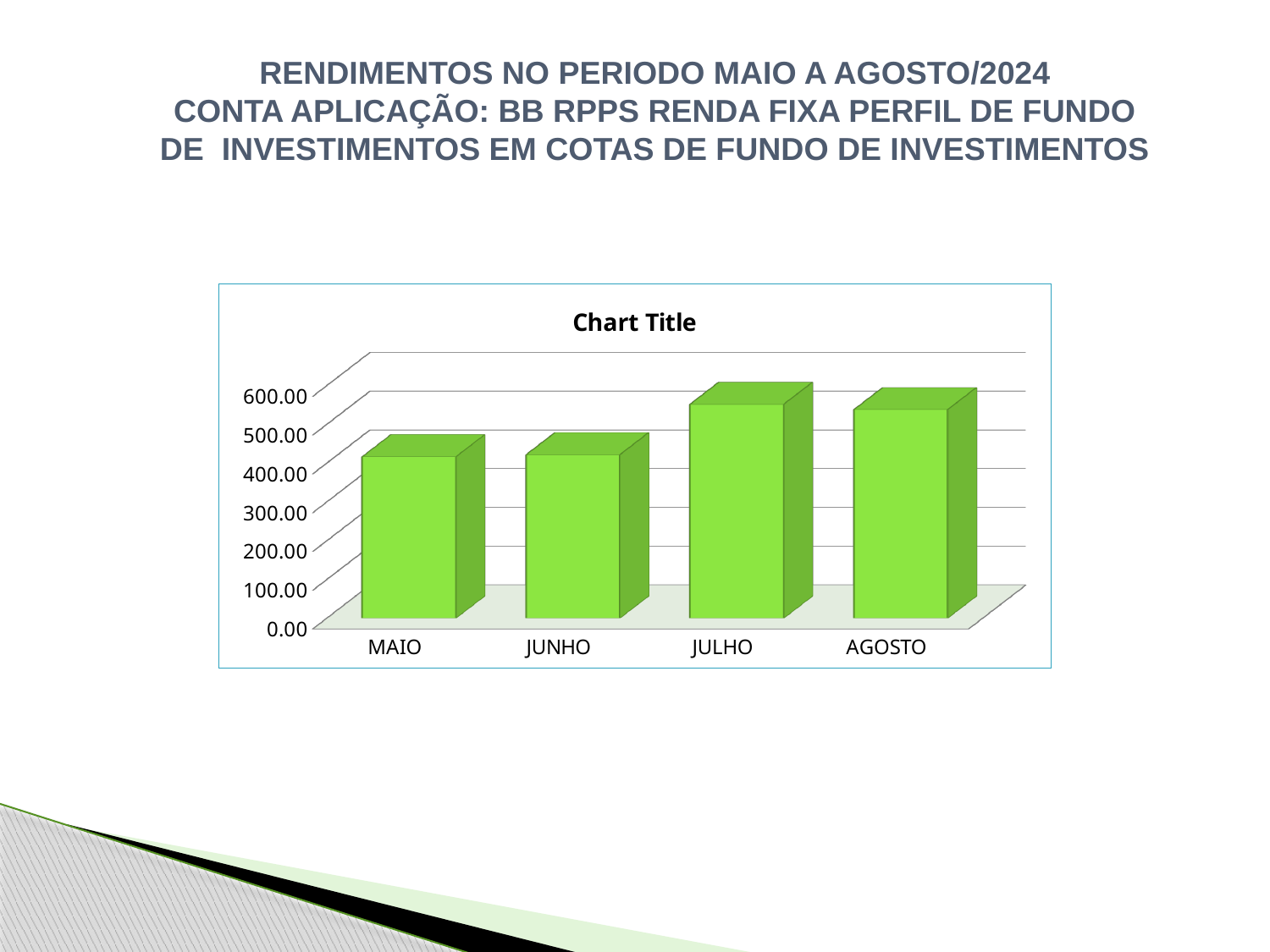
Is the value for AGOSTO greater or less than 600.00? less Is the value for MAIO greater or less than 500.00? less Which months are shown on the x axis of the chart? MAIO, JUNHO, JULHO, AGOSTO Is the value for AGOSTO greater or less than 500.00? greater Which is larger, the value for JULHO or the value for MAIO? JULHO How many categories are shown on the x axis of the chart? 4 What is the title printed inside the chart area? Chart Title What kind of chart is shown on the slide? bar chart Which is larger, the value for JUNHO or the value for AGOSTO? AGOSTO